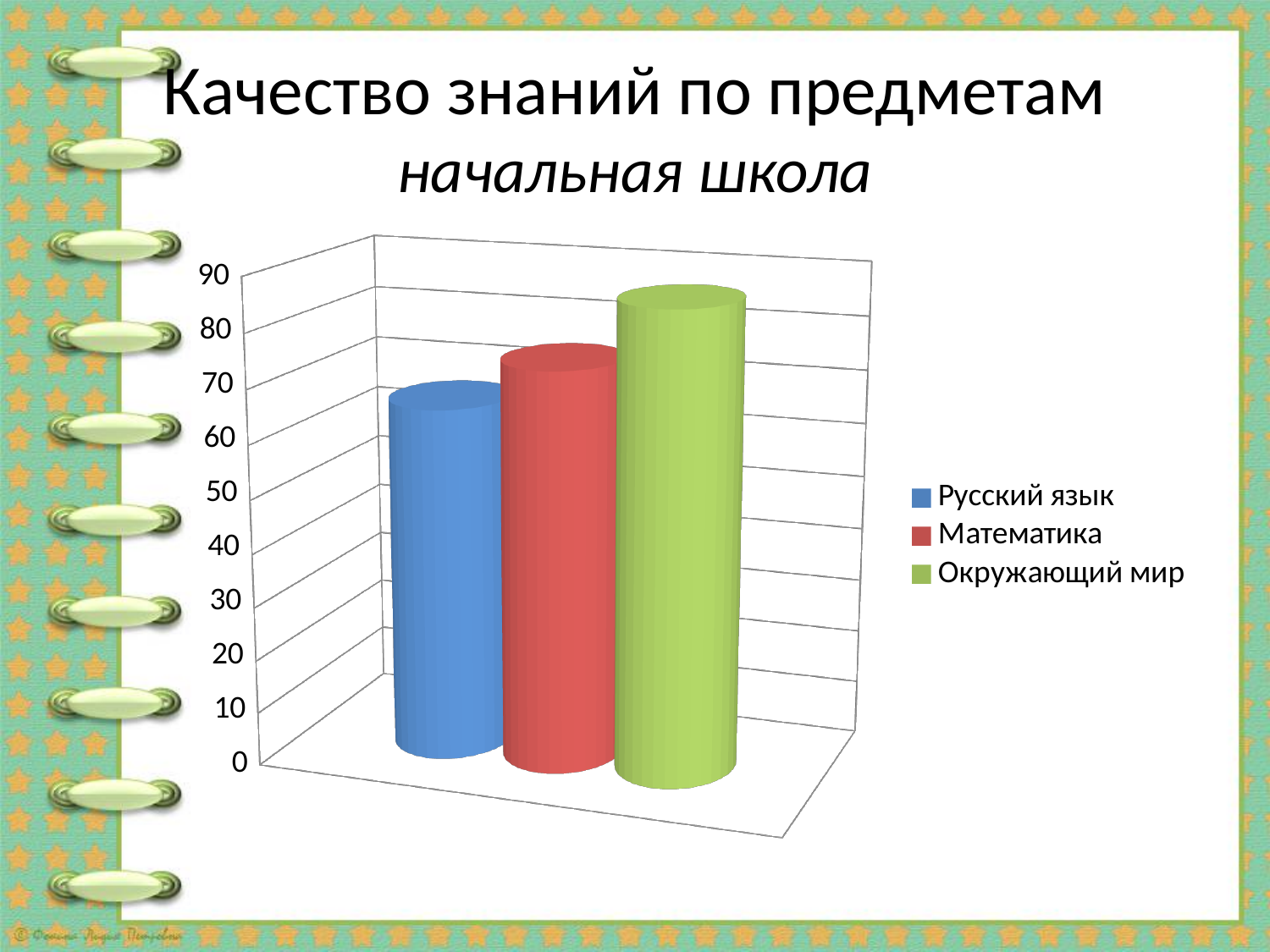
Which series has the lowest value? Русский язык Is the value for Русский язык greater or less than 50? greater Which is larger, the value for Окружающий мир or the value for Математика? Окружающий мир Which series has the highest value? Окружающий мир Which is larger, the value for Математика or the value for Русский язык? Математика How many bars are plotted in the chart? 3 What colour is the bar for Математика? red What is the title of the slide containing the chart? Качество знаний по предметам начальная школа Is the value for Математика greater or less than 60? greater Is the value for Окружающий мир greater or less than 70? greater How many series does the legend list? 3 What kind of chart is shown on the slide? bar chart